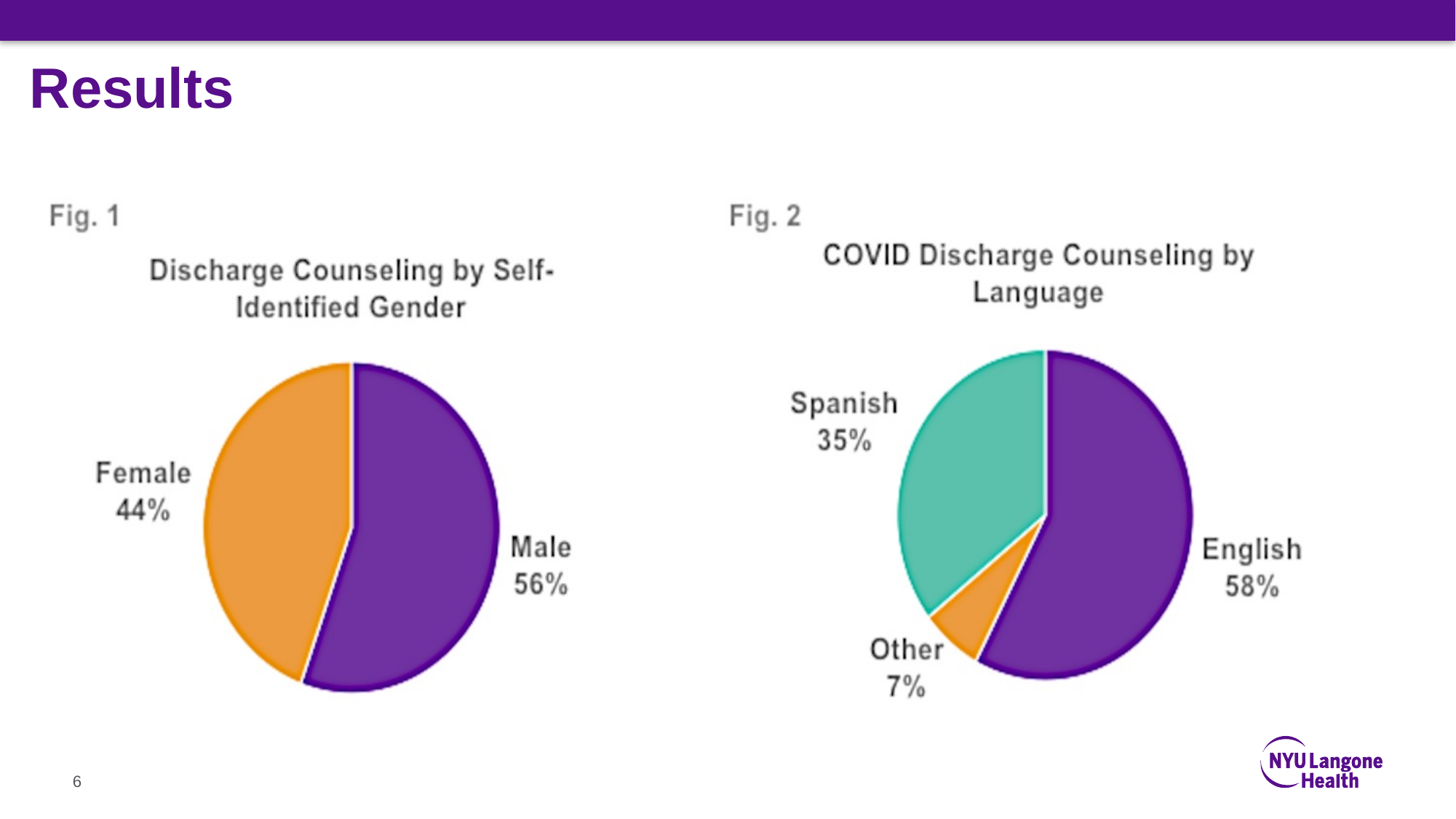
In the 'COVID Discharge Counseling by Language' chart, what share is English? 58% In the 'Discharge Counseling by Self-Identified Gender' chart, what is the difference in percentage points between Male and Female? 12 percentage points What kind of chart is 'Discharge Counseling by Self-Identified Gender'? Pie chart In the 'COVID Discharge Counseling by Language' chart, which language has the smallest share? Other In the 'Discharge Counseling by Self-Identified Gender' chart, what share is Female? 44% In the 'COVID Discharge Counseling by Language' chart, what colour is the Spanish slice? Teal In the 'Discharge Counseling by Self-Identified Gender' chart, which category has the larger share? Male In the 'COVID Discharge Counseling by Language' chart, what share is Other? 7% In the 'COVID Discharge Counseling by Language' chart, how many slices does the pie have? 3 In the 'Discharge Counseling by Self-Identified Gender' chart, what share is Male? 56% In the 'COVID Discharge Counseling by Language' chart, what share is Spanish? 35% In the 'COVID Discharge Counseling by Language' chart, what is the difference in percentage points between English and Spanish? 23 percentage points